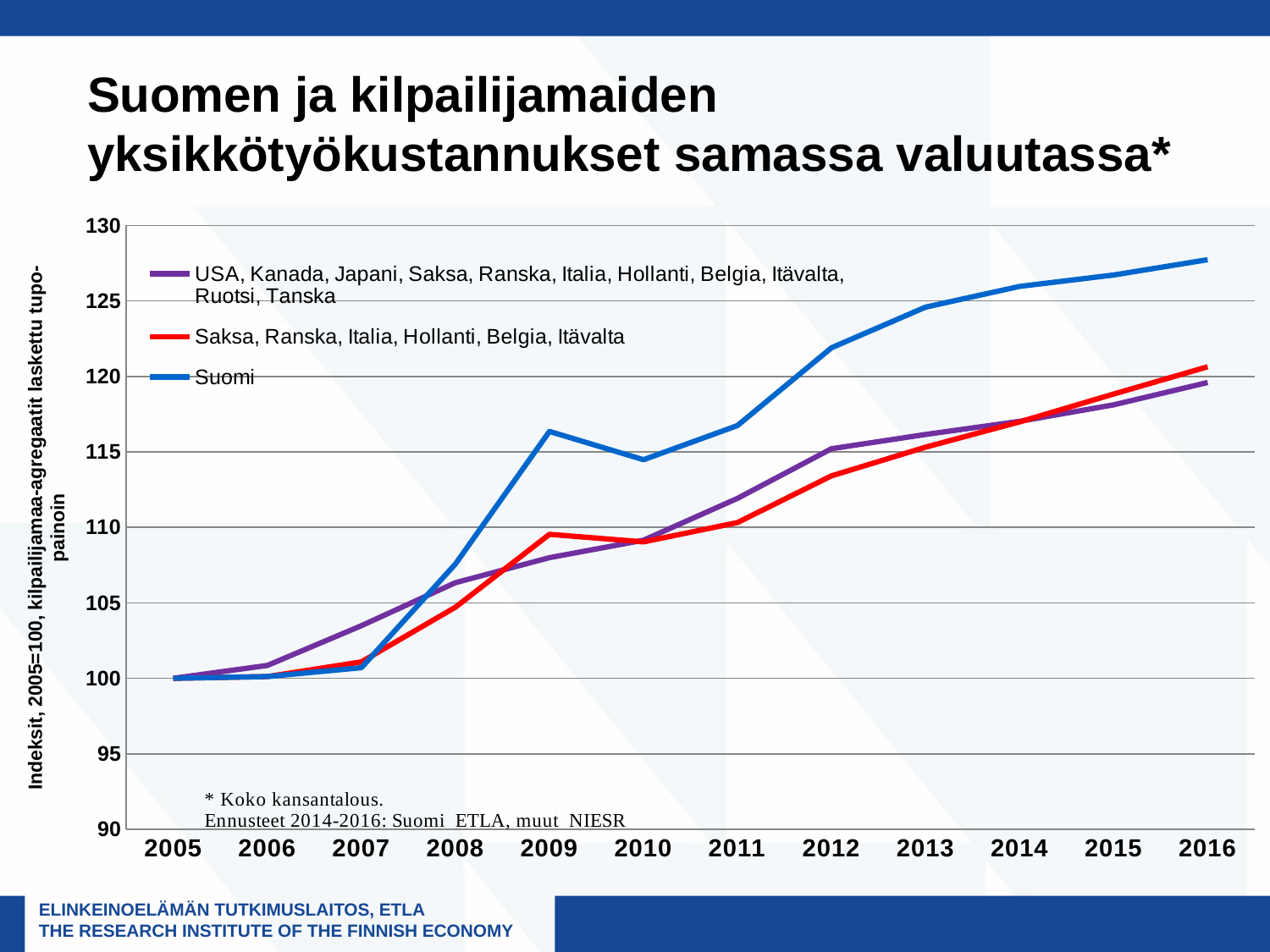
In 2012, which is larger: the value for Suomi or the value for 'USA, Kanada, Japani, Saksa, Ranska, Italia, Hollanti, Belgia, Itävalta, Ruotsi, Tanska'? Suomi How many years are shown along the x axis? 12 What kind of chart is shown on the slide? line chart Does the Suomi line rise or fall overall from 2005 to 2016? rise Is the value for the series 'Saksa, Ranska, Italia, Hollanti, Belgia, Itävalta' in 2012 greater or less than 110? greater Is the value for Suomi in 2016 greater or less than 125? greater What colour is the line for Suomi? blue Is the value for Suomi in 2009 greater or less than 115? greater Which series has the highest value in 2016? Suomi What is the index value for Suomi in 2005? 100 How many series does the legend list? 3